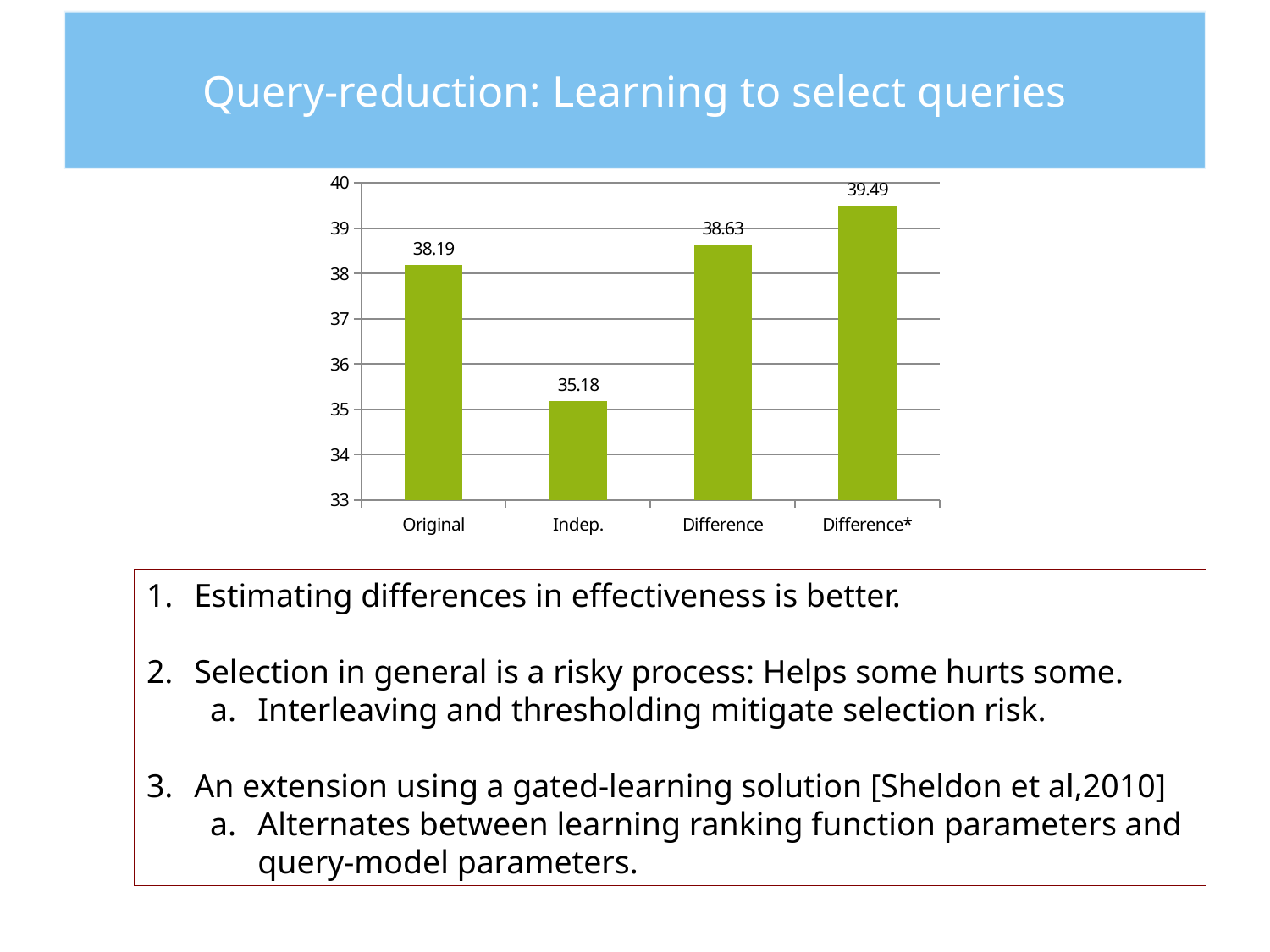
What kind of chart is shown on the slide? bar chart Which category has the lowest value? Indep. What is the value for Indep.? 35.18 Which is larger, the value for Difference or the value for Original? Difference What is the difference between the values for Original and Indep.? 3.01 Is the value for Indep. greater or less than 36? less What is the value for Original? 38.19 Which category has the highest value? Difference* What is the value for Difference? 38.63 How many categories are shown on the x axis? 4 What is the difference between the values for Difference* and Original? 1.30 What is the value for Difference*? 39.49